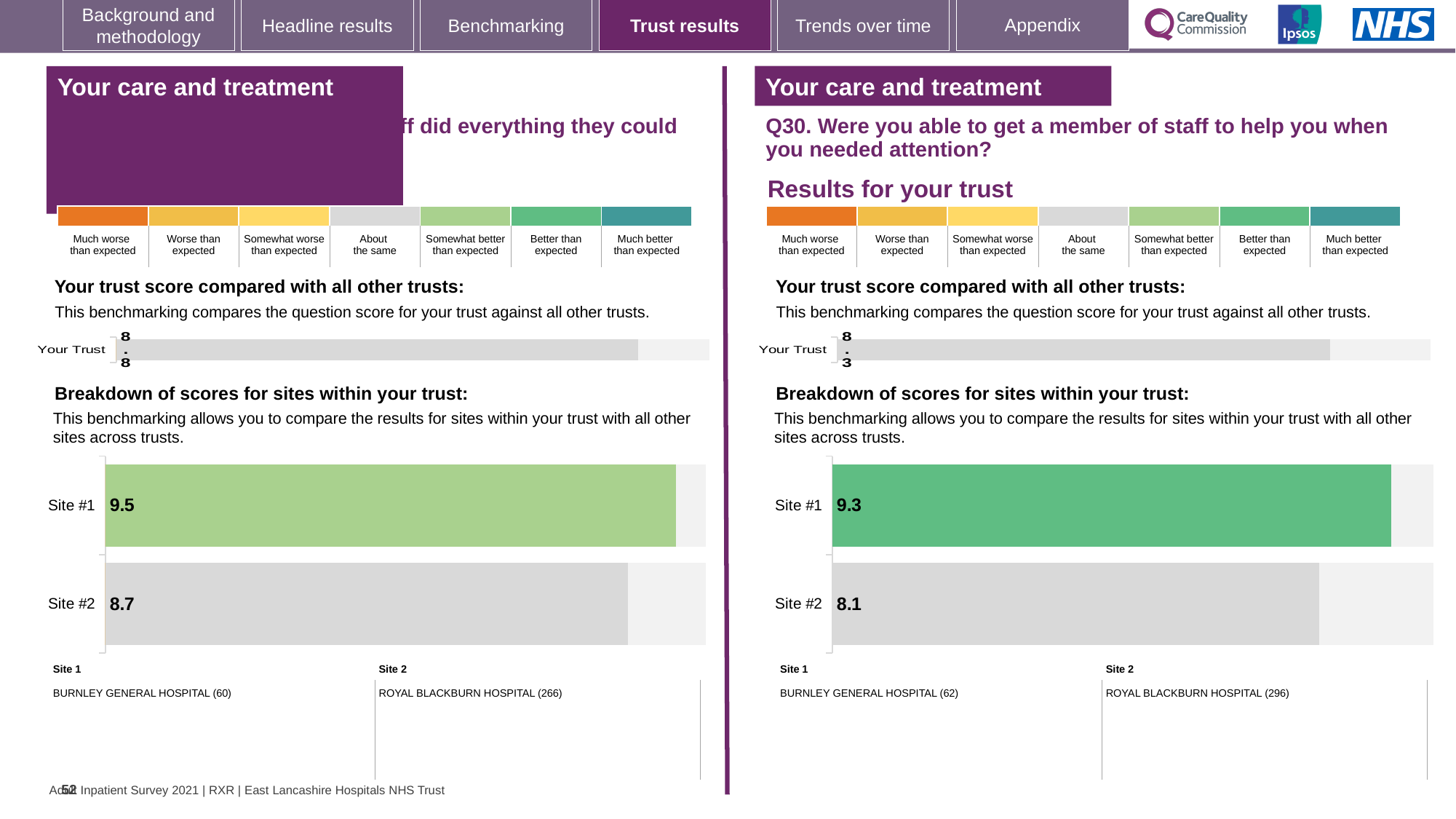
On the Q30 site breakdown chart on the right-hand side of the slide, what is the score for Site #2? 8.1 On the 'Your trust score compared with all other trusts' chart on the left-hand side, what is the score shown for Your Trust? 8.8 What type of chart is the Q30 site breakdown chart on the right-hand side of the slide? Bar chart On the Q30 site breakdown chart on the right-hand side, which site has the higher score? Site #1 How many sites are shown on the Q30 site breakdown chart on the right-hand side? 2 On the site breakdown chart on the left-hand side of the slide, what is the score for Site #1? 9.5 On the Q30 site breakdown chart on the right-hand side, what is the difference between the Site #1 and Site #2 scores? 1.2 On the site breakdown chart on the left-hand side, what is the difference between the Site #1 and Site #2 scores? 0.8 On the Q30 'Your trust score compared with all other trusts' chart on the right-hand side, what is the score shown for Your Trust? 8.3 On the site breakdown chart on the left-hand side of the slide, what is the score for Site #2? 8.7 On the site breakdown chart on the left-hand side, which site has the lower score? Site #2 On the Q30 site breakdown chart on the right-hand side of the slide, what is the score for Site #1? 9.3